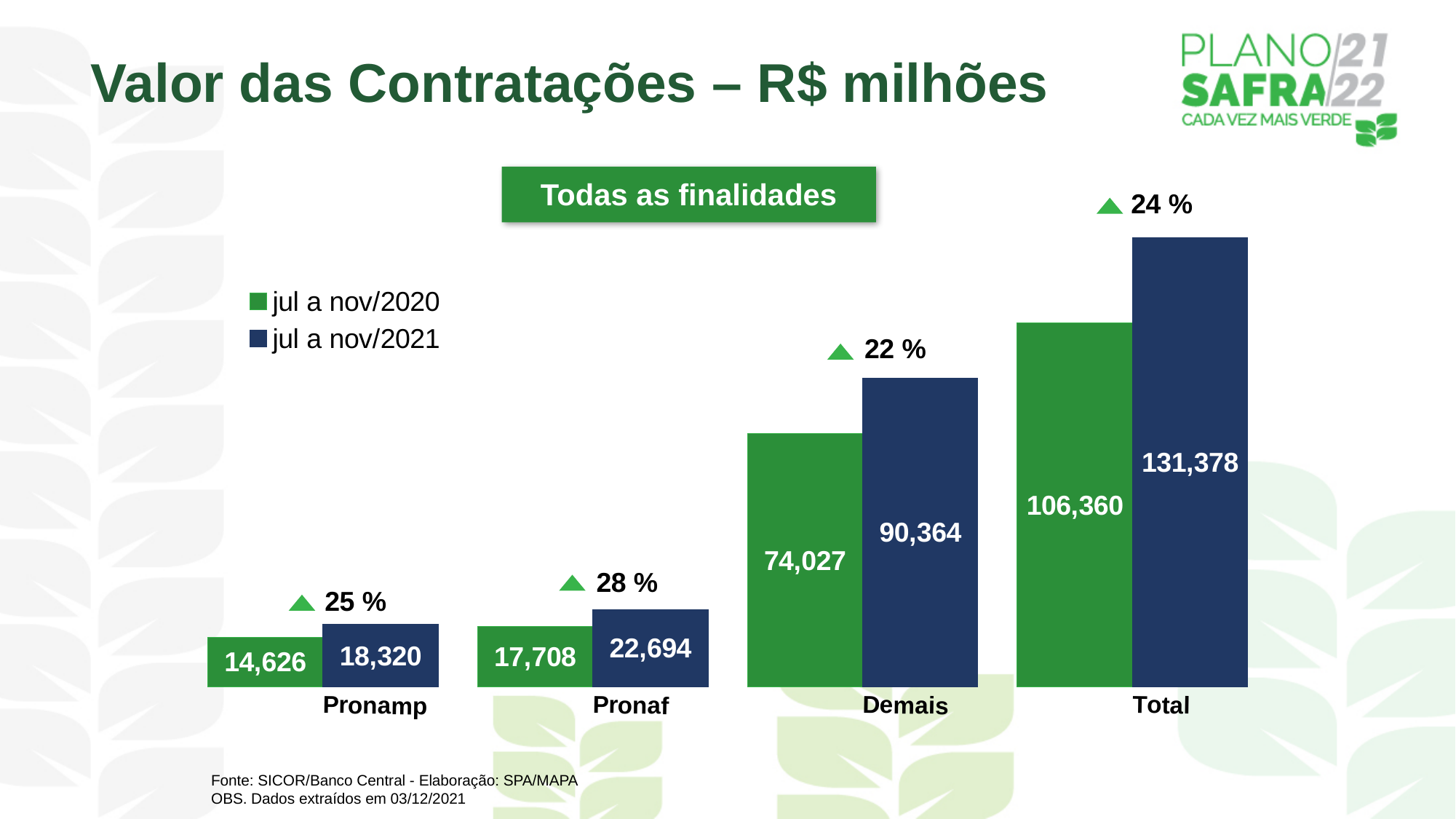
Which category has the highest value in the jul a nov/2021 series? Total What is the value for Pronamp in the jul a nov/2021 series? 18,320 What is the difference between the jul a nov/2021 and jul a nov/2020 values for Pronaf? 4,986 How many categories are shown on the x axis? 4 What is the value for Total in the jul a nov/2021 series? 131,378 What is the difference between the jul a nov/2021 and jul a nov/2020 values for Demais? 16,337 What is the value for Pronaf in the jul a nov/2020 series? 17,708 How many series does the legend list? 2 What percentage increase is shown above the Total bars? 24 % Which is larger: the jul a nov/2020 value for Pronaf or the jul a nov/2021 value for Pronamp? jul a nov/2021 value for Pronamp Which category has the lowest value in the jul a nov/2020 series? Pronamp What is the value for Demais in the jul a nov/2020 series? 74,027